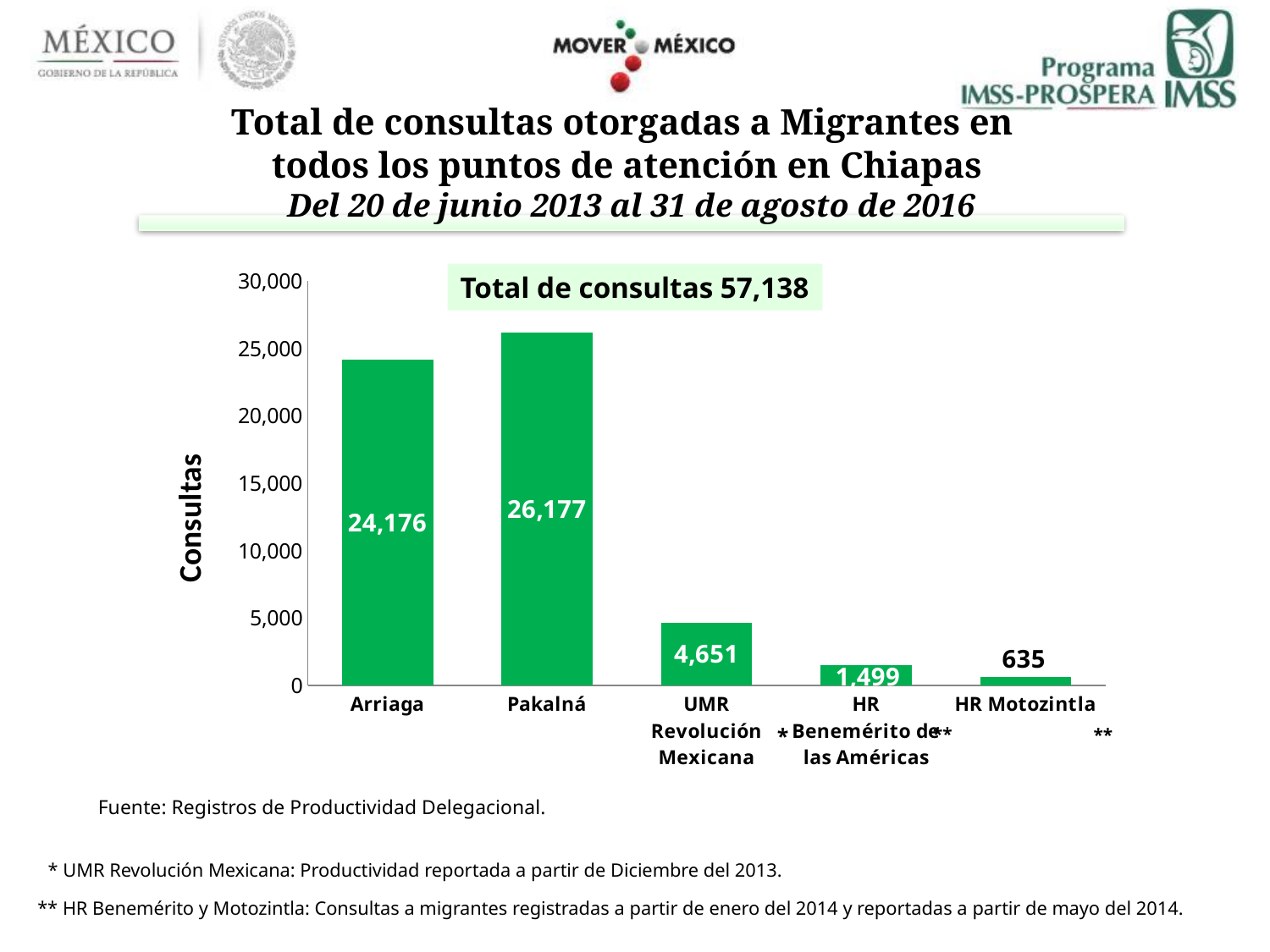
What is the value for Pakalná? 26,177 Which is larger, the value for UMR Revolución Mexicana or the value for HR Benemérito de las Américas? UMR Revolución Mexicana What is the value for UMR Revolución Mexicana? 4,651 What is the difference between the values for Pakalná and Arriaga? 2,001 How many categories are shown on the x axis? 5 What is the value for Arriaga? 24,176 What is the value for HR Motozintla? 635 Which category has the highest value? Pakalná What total number of consultas is stated in the box inside the chart? 57,138 What kind of chart is shown on the slide? bar chart Which category has the lowest value? HR Motozintla Is the value for Arriaga greater or less than 20,000? greater